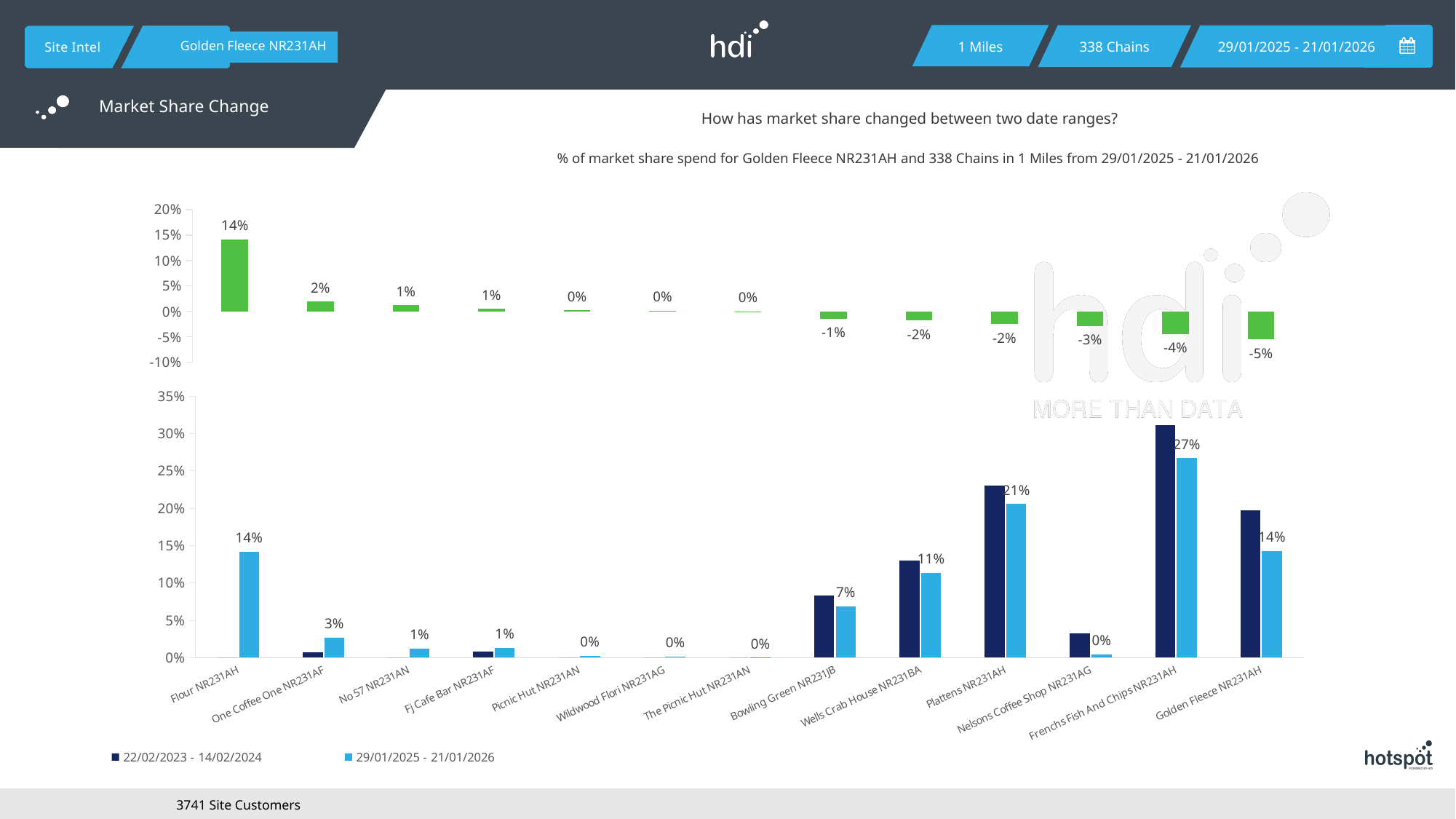
In the bottom chart, what is the value for Plattens NR231AH in the 29/01/2025 - 21/01/2026 series? 21% In the bottom chart, which is larger for Wells Crab House NR231BA: the 22/02/2023 - 14/02/2024 value or the 29/01/2025 - 21/01/2026 value? 22/02/2023 - 14/02/2024 How many series does the legend of the bottom chart list? 2 In the bottom chart, what is the value for Frenchs Fish And Chips NR231AH in the 29/01/2025 - 21/01/2026 series? 27% In the top chart (market share change), what is the value for Flour NR231AH? 14% How many categories are shown on the x axis of the bottom chart? 13 In the top chart (market share change), which category has the highest value? Flour NR231AH In the top chart (market share change), which category has the lowest value? Golden Fleece NR231AH In the top chart (market share change), what is the value for Frenchs Fish And Chips NR231AH? -4% In the bottom chart, what is the difference between the 29/01/2025 - 21/01/2026 values for Frenchs Fish And Chips NR231AH and Golden Fleece NR231AH? 13% In the top chart (market share change), what is the value for Golden Fleece NR231AH? -5% In the bottom chart, is the 22/02/2023 - 14/02/2024 value for Frenchs Fish And Chips NR231AH greater or less than 30%? greater